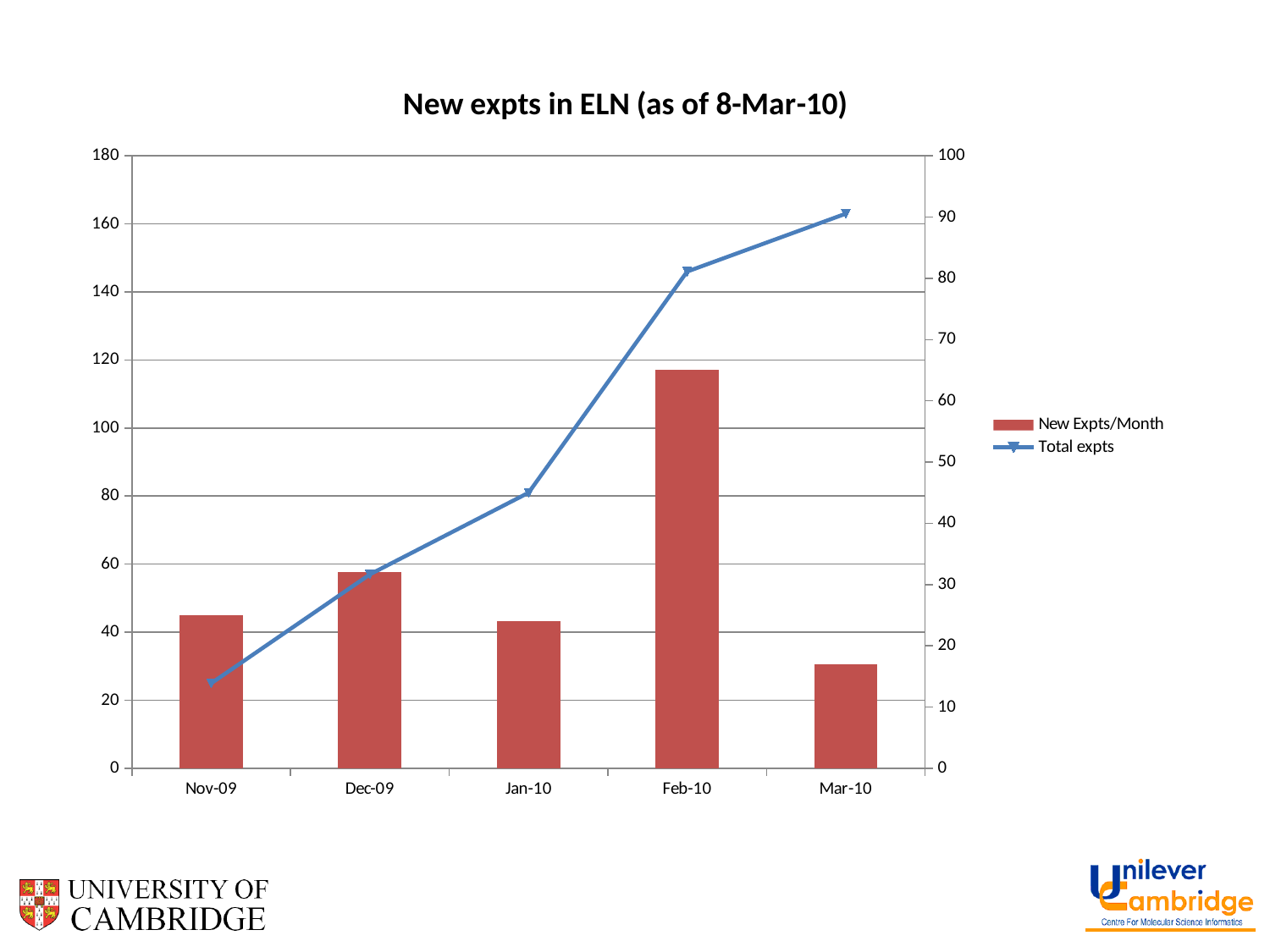
What is the title of the chart? New expts in ELN (as of 8-Mar-10) How many series does the legend list? 2 Is the New Expts/Month value for Mar-10 greater or less than 40? less How many months are shown on the x axis? 5 What kind of chart is shown on the slide? A combined bar and line chart Is the Total expts value for Jan-10 greater or less than 40 on the right-hand axis? greater Which month has the highest value for New Expts/Month? Feb-10 Does the Total expts line rise or fall from Nov-09 to Mar-10? Rises Is the New Expts/Month value for Dec-09 greater or less than 60? less Which is larger, the New Expts/Month value for Dec-09 or for Nov-09? Dec-09 Which month has the lowest value for New Expts/Month? Mar-10